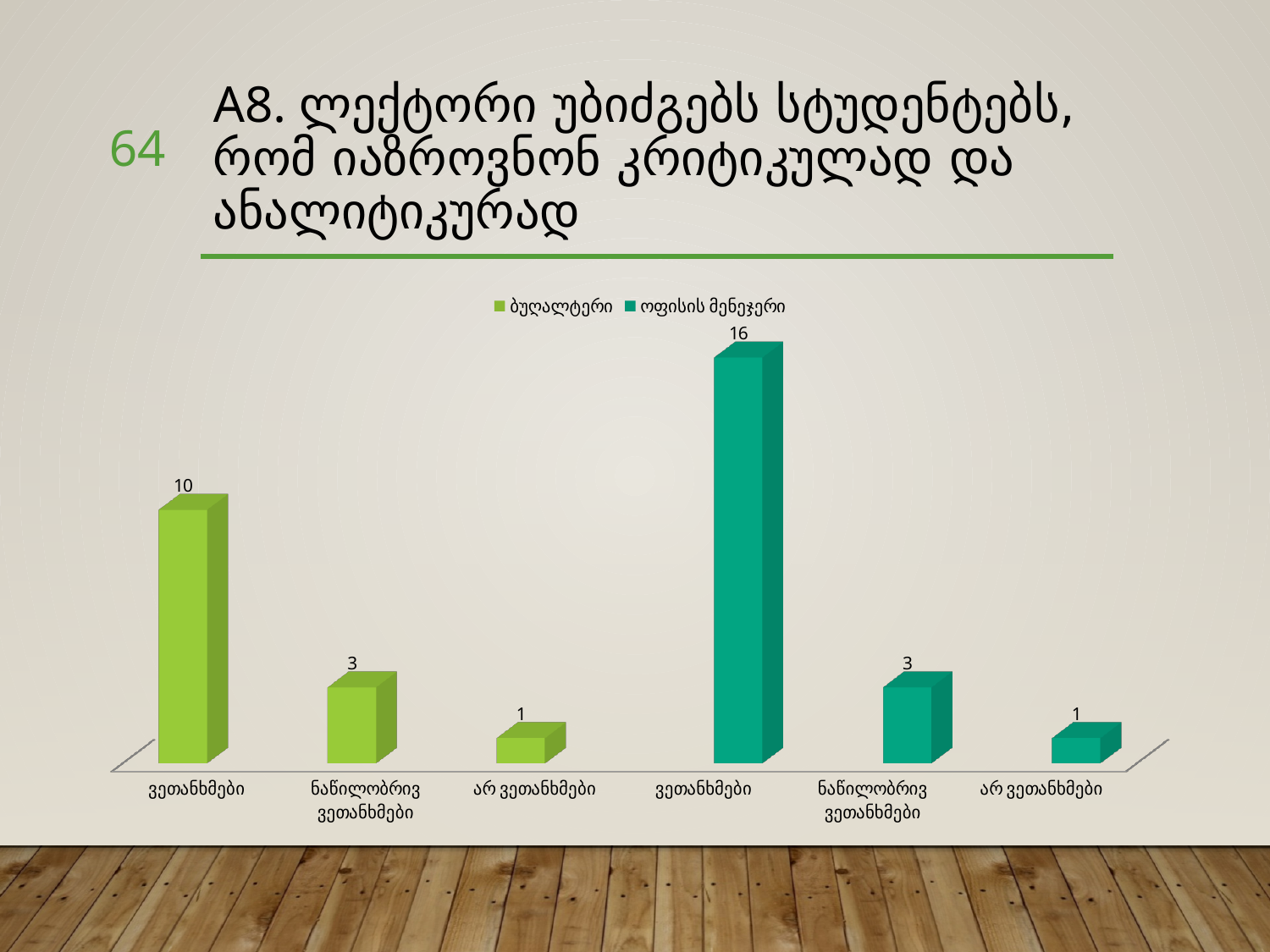
How many bars are plotted in the chart? 6 What type of chart is shown on the slide? bar chart What colour are the bars of the ოფისის მენეჯერი series? teal Which bar has the highest value in the chart? ვეთანხმები (ოფისის მენეჯერი) How many series does the chart legend list? 2 Which is larger: the ვეთანხმები value for ბუღალტერი or for ოფისის მენეჯერი? ოფისის მენეჯერი What is the value for არ ვეთანხმები in the ბუღალტერი series? 1 What is the value for ვეთანხმები in the ბუღალტერი series? 10 What is the difference between the ვეთანხმები values of the ოფისის მენეჯერი and ბუღალტერი series? 6 What is the value for ნაწილობრივ ვეთანხმები in the ოფისის მენეჯერი series? 3 What is the value for ვეთანხმები in the ოფისის მენეჯერი series? 16 Which category has the lowest value in the ბუღალტერი series? არ ვეთანხმები